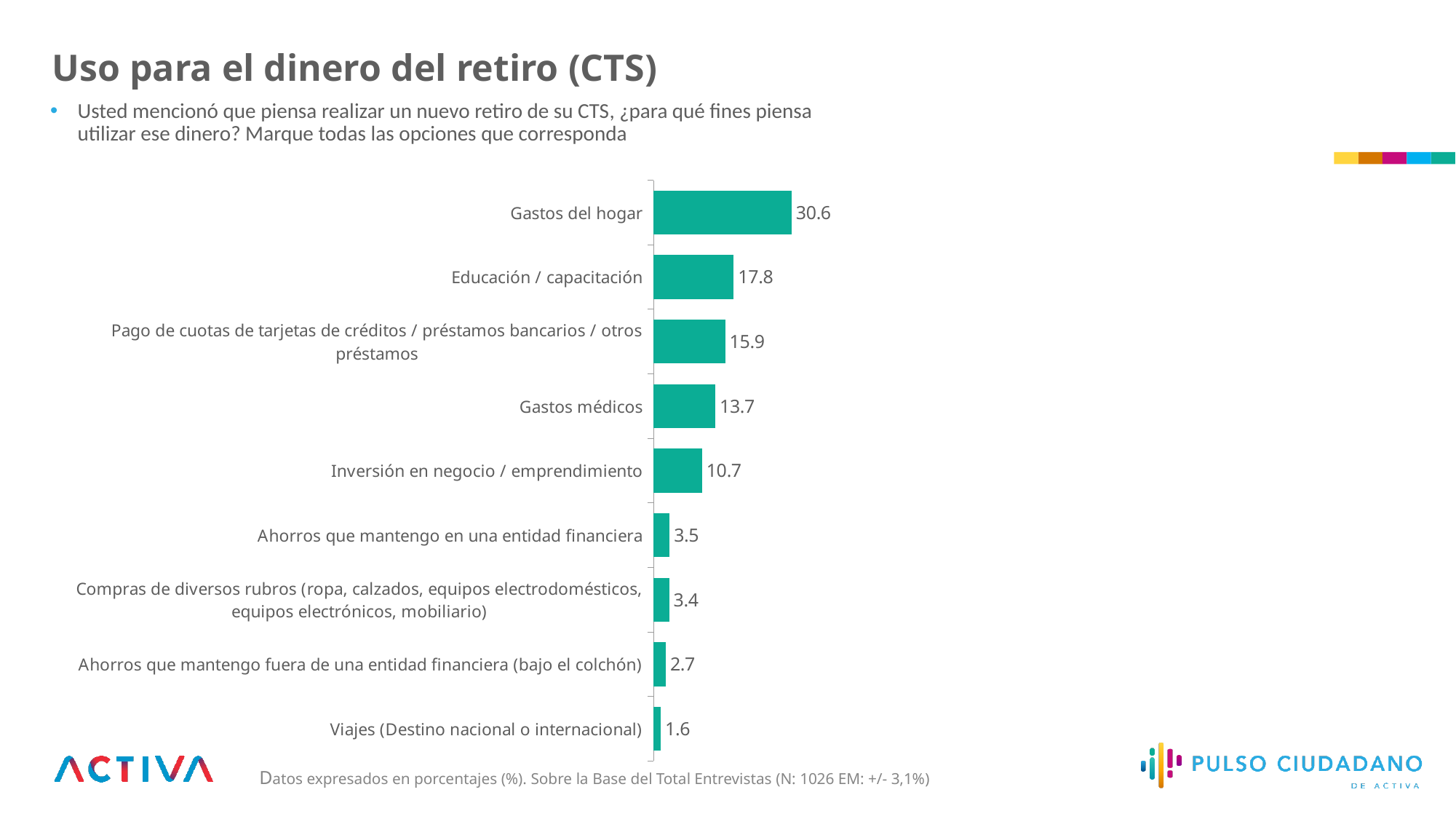
Which category has the lowest value? Viajes (Destino nacional o internacional) What is the value for Inversión en negocio / emprendimiento? 10.7 What is the difference between the values for Gastos médicos and Inversión en negocio / emprendimiento? 3.0 What is the value for Viajes (Destino nacional o internacional)? 1.6 How many categories are shown in the chart? 9 What is the title of the slide? Uso para el dinero del retiro (CTS) What is the difference between the values for Gastos del hogar and Educación / capacitación? 12.8 Which category has the highest value? Gastos del hogar What is the value for Educación / capacitación? 17.8 What kind of chart is shown on the slide? Bar chart What is the value for Gastos del hogar? 30.6 Which is larger, the value for Gastos médicos or the value for Pago de cuotas de tarjetas de créditos / préstamos bancarios / otros préstamos? Pago de cuotas de tarjetas de créditos / préstamos bancarios / otros préstamos